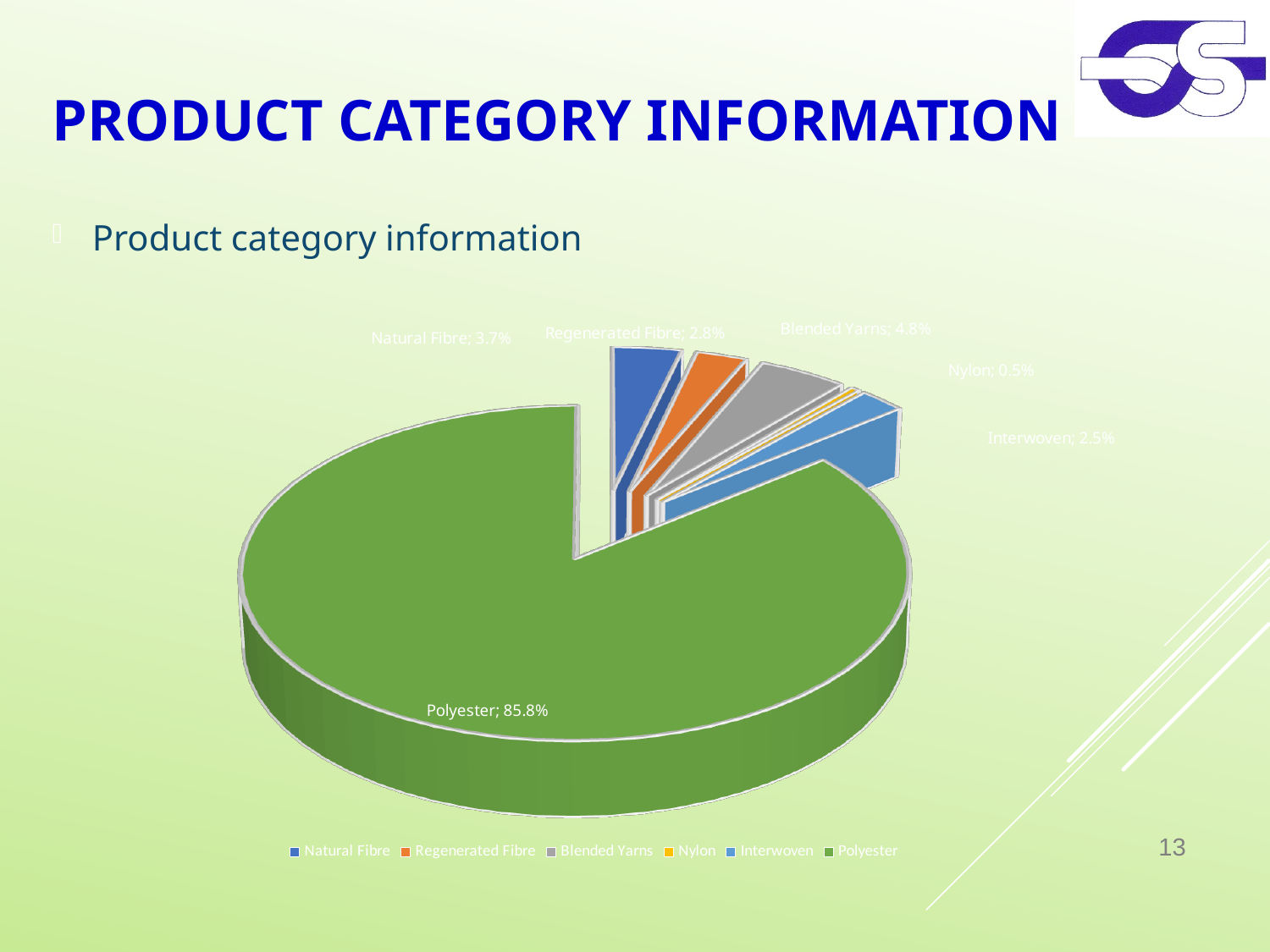
Which is larger, Regenerated Fibre or Blended Yarns? Blended Yarns What is the value shown for Blended Yarns? 4.8% Which colour represents Polyester in the legend? green Which category has the smallest slice of the pie? Nylon What share of the pie does Polyester have? 85.8% How many categories does the pie chart show? 6 What kind of chart is shown on the slide? pie chart Which category has the largest slice of the pie? Polyester What is the value shown for Interwoven? 2.5% What is the value shown for Natural Fibre? 3.7% What is the difference between the Natural Fibre and Regenerated Fibre shares? 0.9% What is the value shown for Nylon? 0.5%